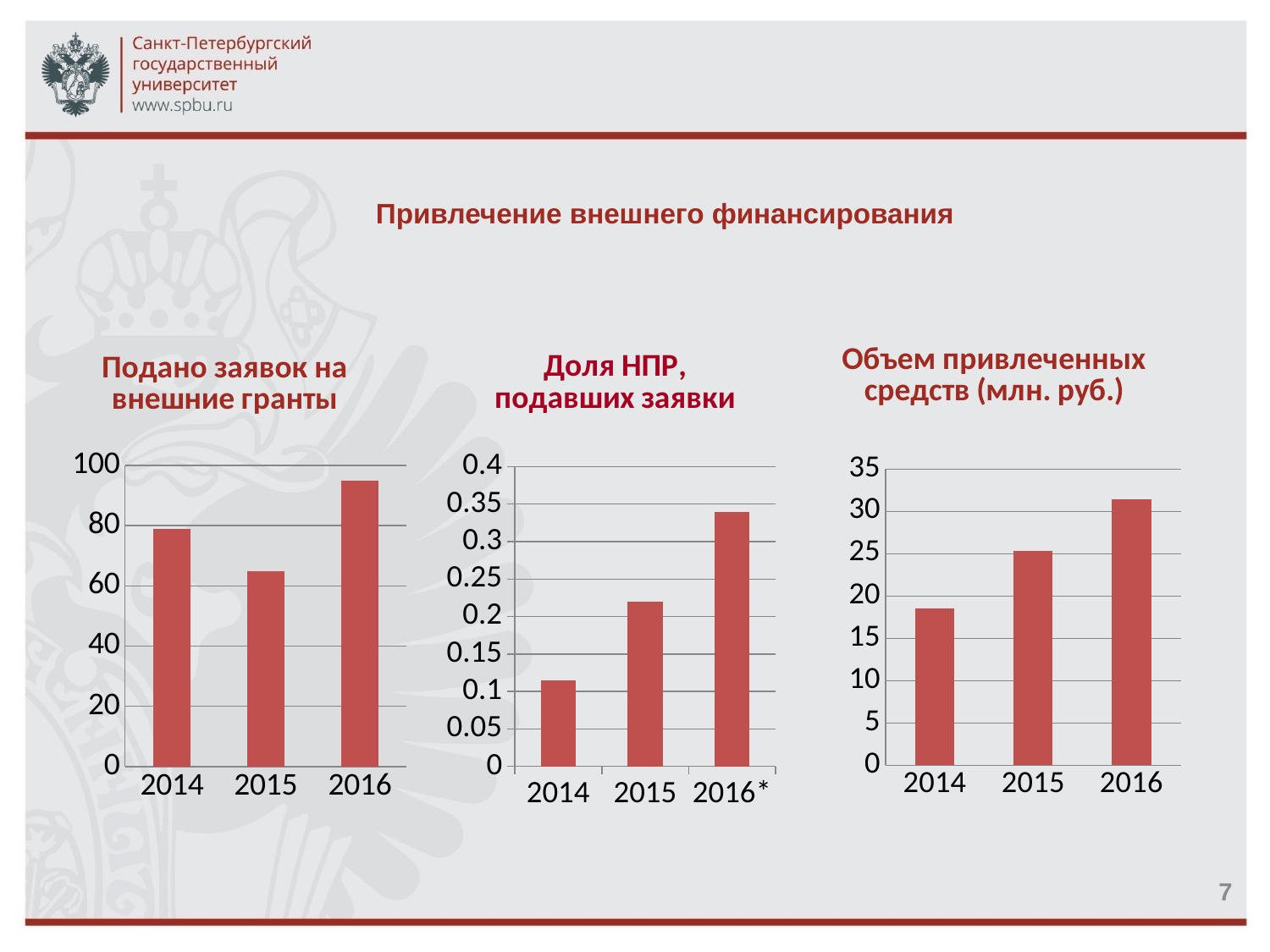
In the chart titled "Объем привлеченных средств (млн. руб.)", which year has the lowest value? 2014 What type of chart is the chart titled "Подано заявок на внешние гранты"? bar chart In the chart titled "Доля НПР, подавших заявки", which category has the highest value? 2016* In the chart titled "Объем привлеченных средств (млн. руб.)", is the value for 2016 greater or less than 30? greater In the chart titled "Объем привлеченных средств (млн. руб.)", which is larger, the value for 2014 or the value for 2015? 2015 In the chart titled "Доля НПР, подавших заявки", is the value for 2014 greater or less than 0.15? less In the chart titled "Доля НПР, подавших заявки", do the values rise or fall from 2014 to 2016*? rise How many bars are shown in the chart titled "Объем привлеченных средств (млн. руб.)"? 3 In the chart titled "Подано заявок на внешние гранты", which year has the lowest value? 2015 In the chart titled "Подано заявок на внешние гранты", is the value for 2015 greater or less than 60? greater In the chart titled "Подано заявок на внешние гранты", which year has the highest value? 2016